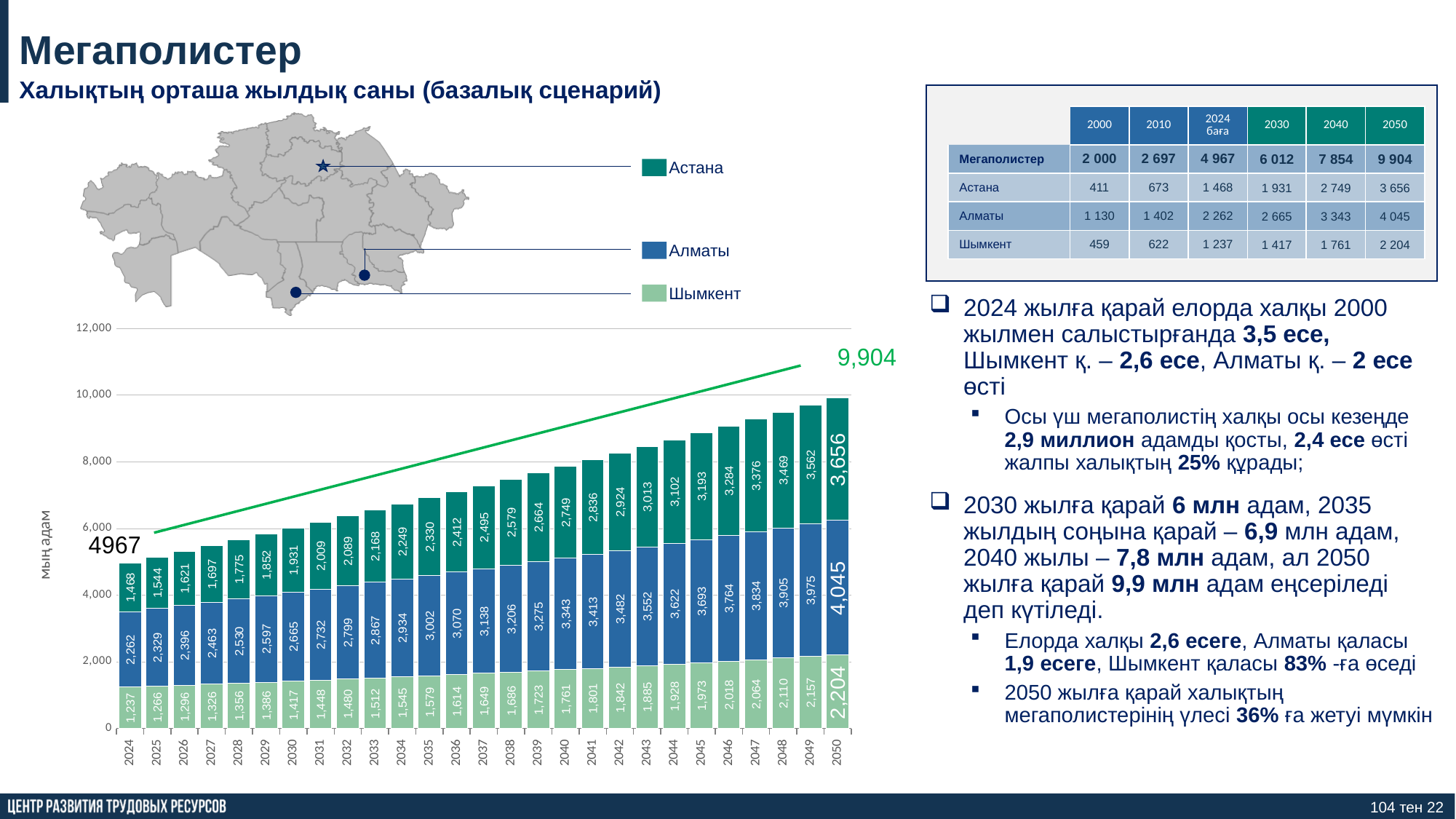
How many years (bars) are shown on the x axis? 27 What is the total of the stacked bar for 2050, as labelled on the chart? 9,904 What is the value for Астана in 2040? 2,749 Is the total stacked bar for 2045 greater or less than 8,000? greater What is the value for Астана in 2024? 1,468 Which year has the lowest total stacked bar? 2024 Which is larger in 2035, the value for Астана or the value for Шымкент? Астана What is the value for Алматы in 2050? 4,045 How many series does the legend list? 3 Which series has the largest value in 2050? Алматы What is the difference between the Алматы values for 2050 and 2024? 1,783 What is the value for Шымкент in 2030? 1,417